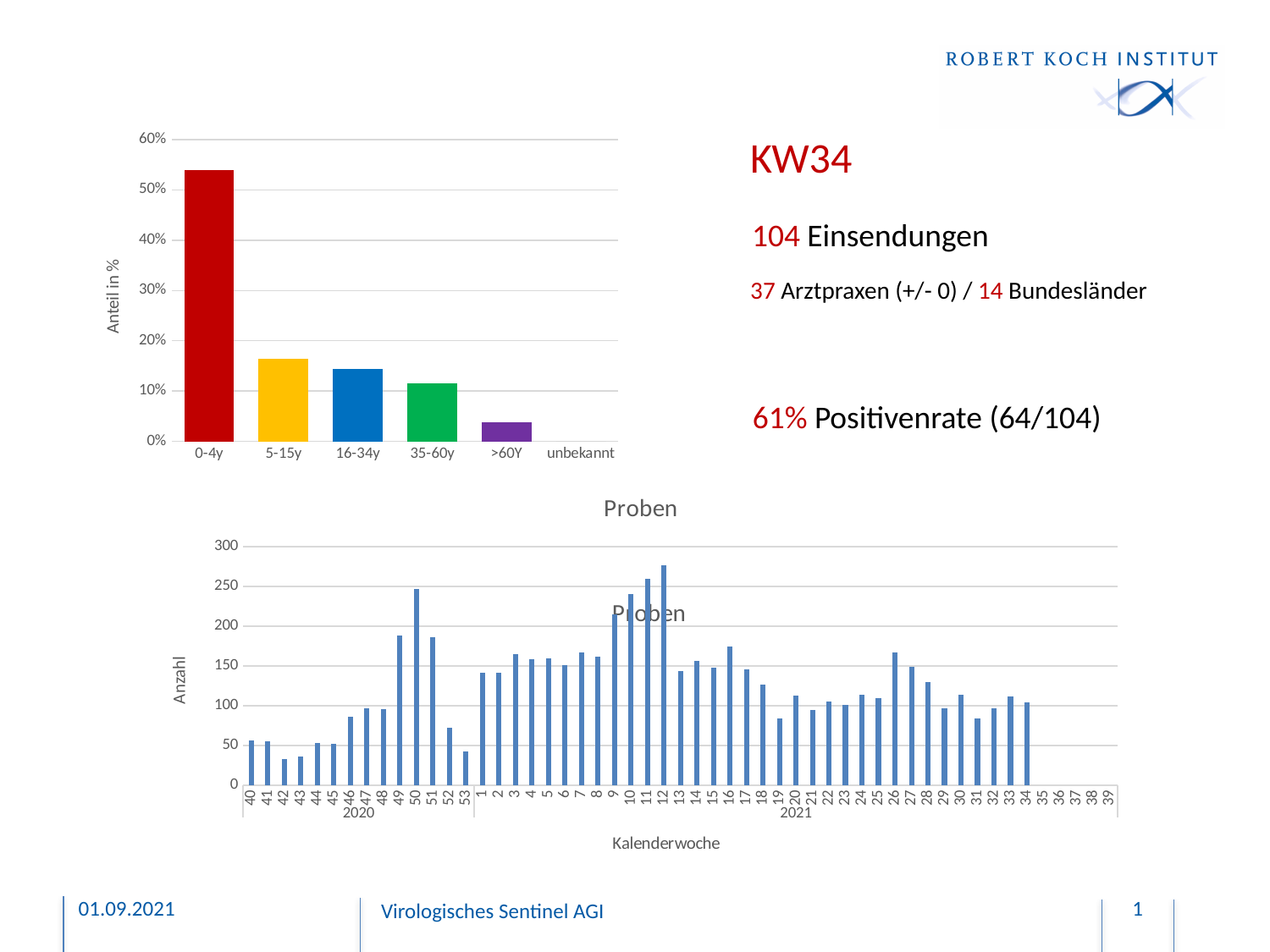
What is the y-axis title of the top-left age-group chart? Anteil in % In the bottom 'Proben' chart, is the value for week 19 of 2021 greater or less than 100? less In the bottom 'Proben' chart, which calendar week has the highest number of samples? 12 (2021) How many age-group categories are shown on the x axis of the top-left chart? 6 In the top-left age-group chart, is the value for 5-15y greater or less than 20%? less In the top-left age-group chart, which is larger, the value for 5-15y or the value for 35-60y? 5-15y What is the title of the bottom chart? Proben In the top-left age-group chart, is the value for 0-4y greater or less than 50%? greater In the top-left age-group chart, which age group has the highest share? 0-4y What kind of chart is the top-left chart with the age groups? bar chart